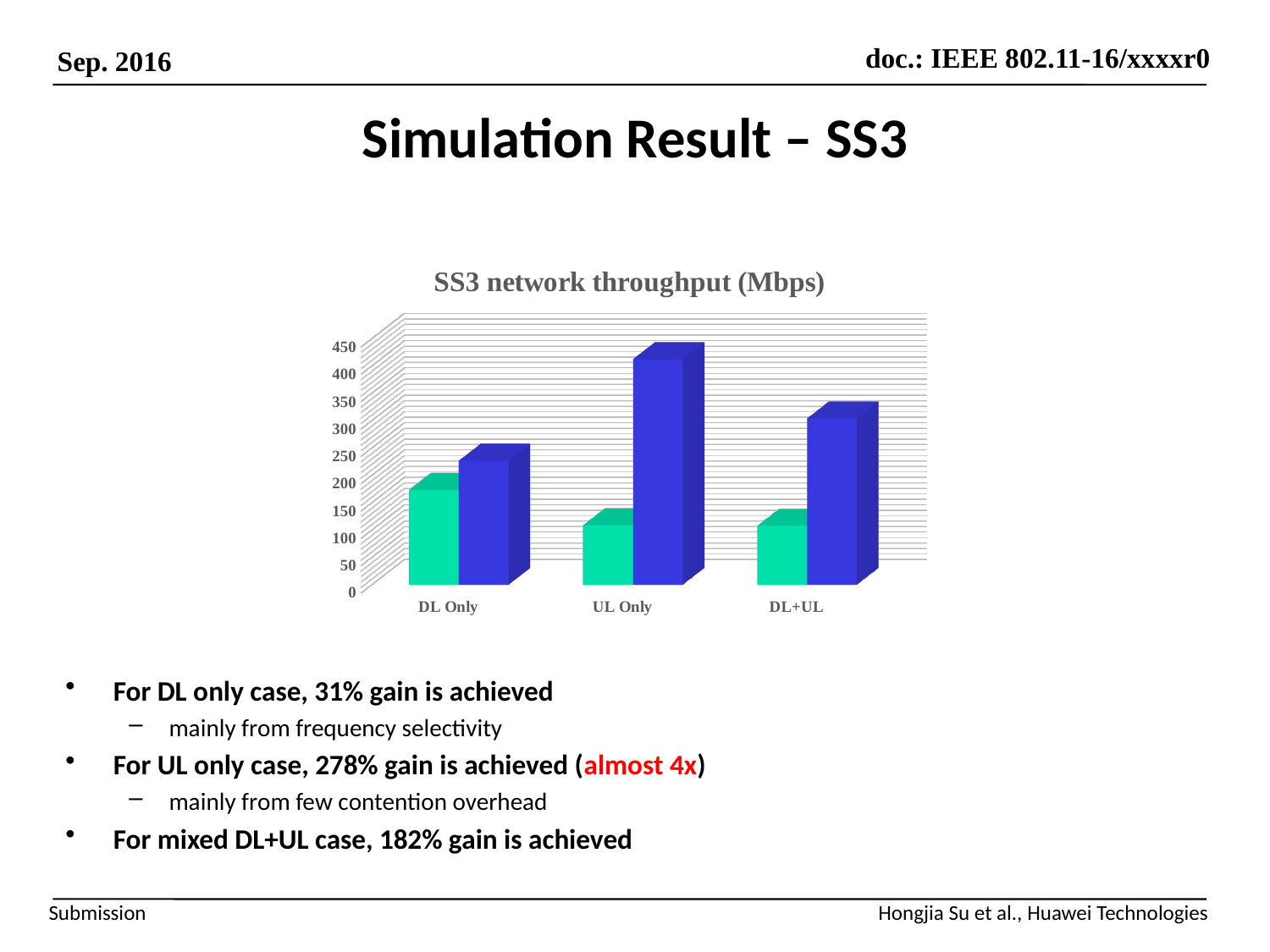
How many categories are shown on the x axis of the chart? 3 What is the title of the chart? SS3 network throughput (Mbps) Which category has the tallest blue bar? UL Only Is the value of the green bar for UL Only greater or less than 150? less Which is larger, the blue bar for UL Only or the blue bar for DL+UL? the blue bar for UL Only How many bars are plotted for each category in the chart? 2 Is the value of the blue bar for DL+UL greater or less than 250? greater For the DL Only category, which bar is taller, the green bar or the blue bar? the blue bar What kind of chart is shown on the slide? bar chart Is the value of the green bar for DL Only greater or less than 150? greater Which category has the tallest green bar? DL Only